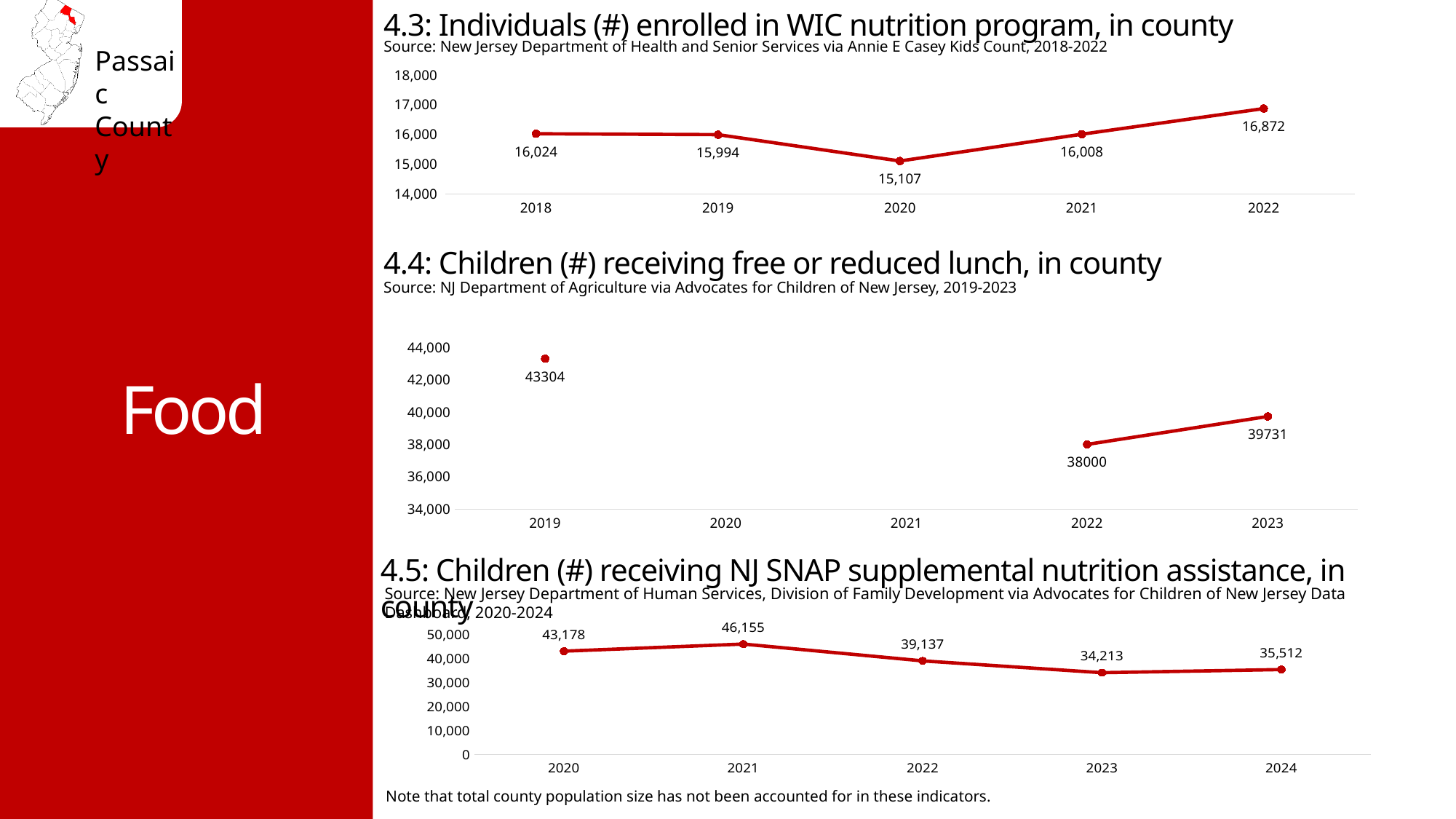
In the chart '4.3: Individuals (#) enrolled in WIC nutrition program, in county', how many years are plotted? 5 In the chart '4.3: Individuals (#) enrolled in WIC nutrition program, in county', what is the value for 2020? 15,107 What kind of chart is '4.5: Children (#) receiving NJ SNAP supplemental nutrition assistance, in county'? Line chart In the chart '4.4: Children (#) receiving free or reduced lunch, in county', what is the difference between the 2023 and 2022 values? 1731 In the chart '4.3: Individuals (#) enrolled in WIC nutrition program, in county', which year has the highest value? 2022 In the chart '4.5: Children (#) receiving NJ SNAP supplemental nutrition assistance, in county', which year has the lowest value? 2023 In the chart '4.5: Children (#) receiving NJ SNAP supplemental nutrition assistance, in county', is the value for 2020 larger or the value for 2024? 2020 In the chart '4.4: Children (#) receiving free or reduced lunch, in county', how many data points are plotted? 3 In the chart '4.4: Children (#) receiving free or reduced lunch, in county', which year has the lowest plotted value? 2022 In the chart '4.4: Children (#) receiving free or reduced lunch, in county', what is the value for 2019? 43304 In the chart '4.5: Children (#) receiving NJ SNAP supplemental nutrition assistance, in county', what is the value for 2021? 46,155 In the chart '4.3: Individuals (#) enrolled in WIC nutrition program, in county', what is the difference between the 2022 and 2021 values? 864